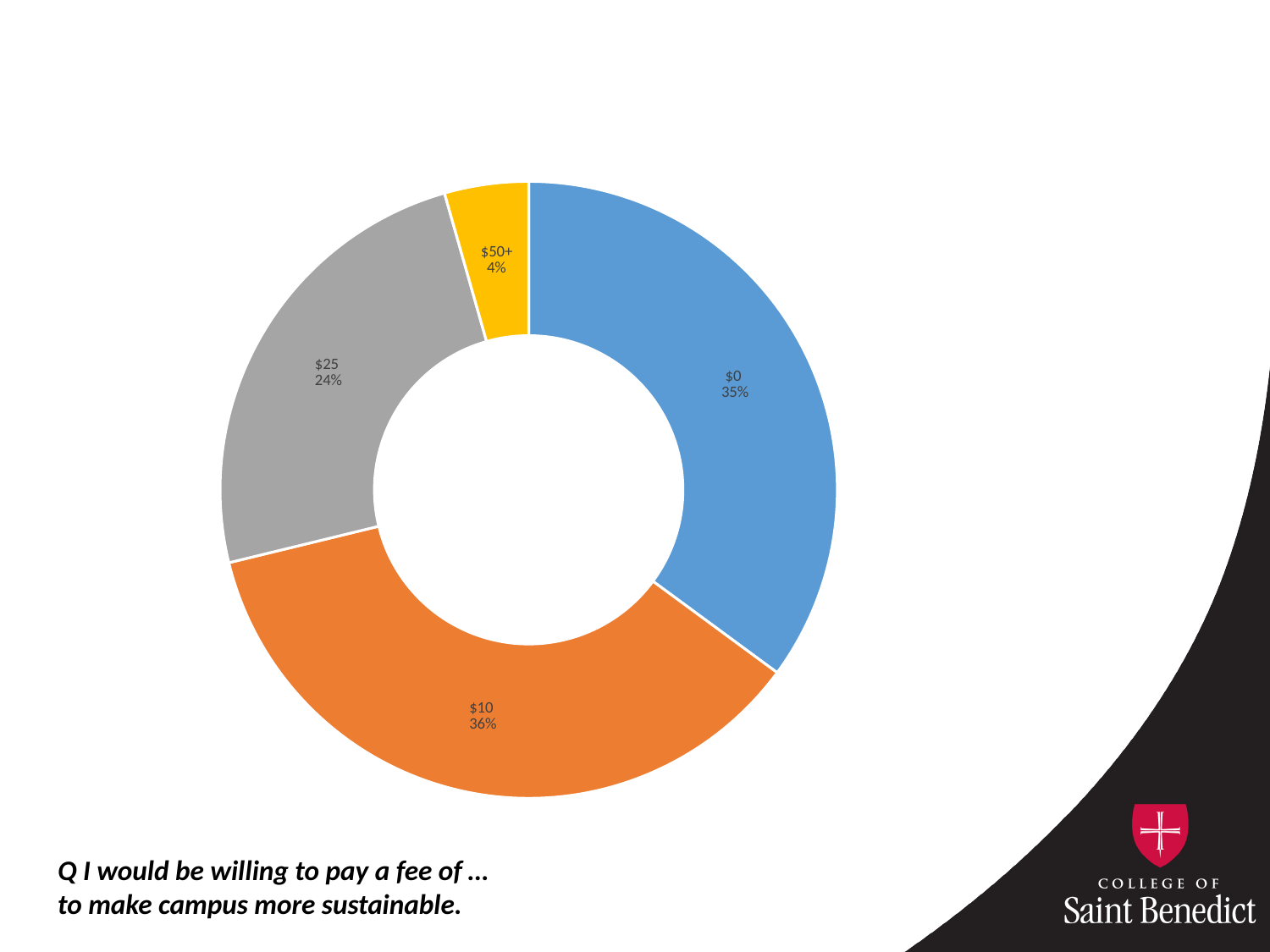
What is the difference in percentage points between the $0 slice and the $25 slice? 11 percentage points What percentage of respondents would be willing to pay a fee of $0? 35% What kind of chart is shown on the slide? Doughnut (pie) chart What is the difference in percentage points between the $25 slice and the $50+ slice? 20 percentage points Which fee option has the smallest slice of the chart? $50+ What share of the chart does the $25 slice represent? 24% Which slice is larger, $25 or $50+? $25 What percentage of respondents chose $10 as the fee they would be willing to pay? 36% How many fee categories are shown in the chart? 4 What colour is the $10 slice of the chart? Orange Which slice is larger, $0 or $25? $0 What percentage is shown for the $50+ slice? 4%